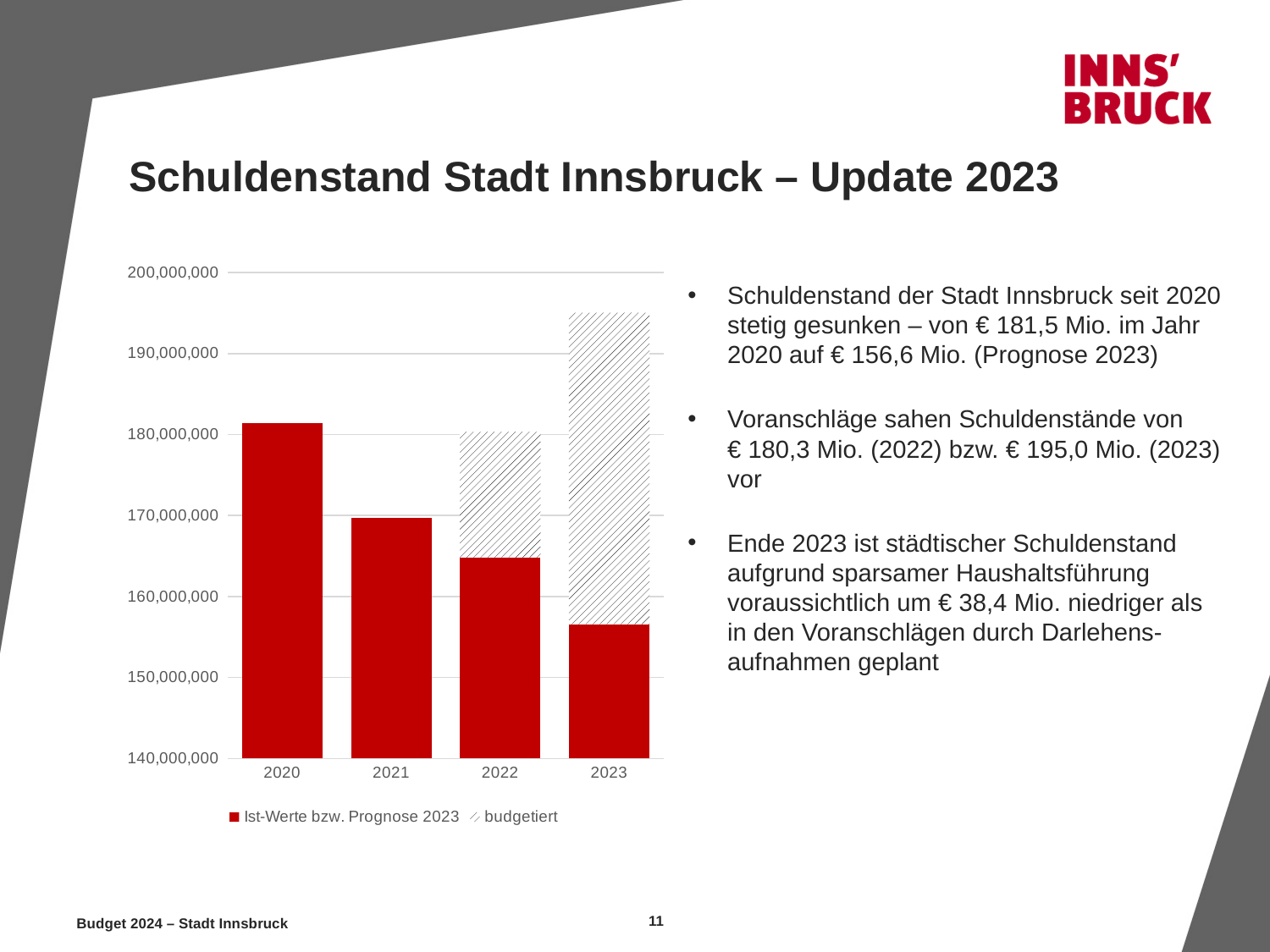
Which year has the highest value for the series 'Ist-Werte bzw. Prognose 2023'? 2020 Do the 'Ist-Werte bzw. Prognose 2023' values rise or fall from 2020 to 2023? fall What kind of chart is shown on the slide? bar chart What are the two entries in the chart legend? Ist-Werte bzw. Prognose 2023; budgetiert Which year has the lowest value for the series 'Ist-Werte bzw. Prognose 2023'? 2023 Is the 'Ist-Werte bzw. Prognose 2023' value for 2020 greater or less than 170,000,000? greater How many series does the chart legend list? 2 Is the 'Ist-Werte bzw. Prognose 2023' value for 2023 greater or less than 160,000,000? less Is the 'Ist-Werte bzw. Prognose 2023' value for 2022 greater or less than 170,000,000? less How many years are shown on the x axis of the chart? 4